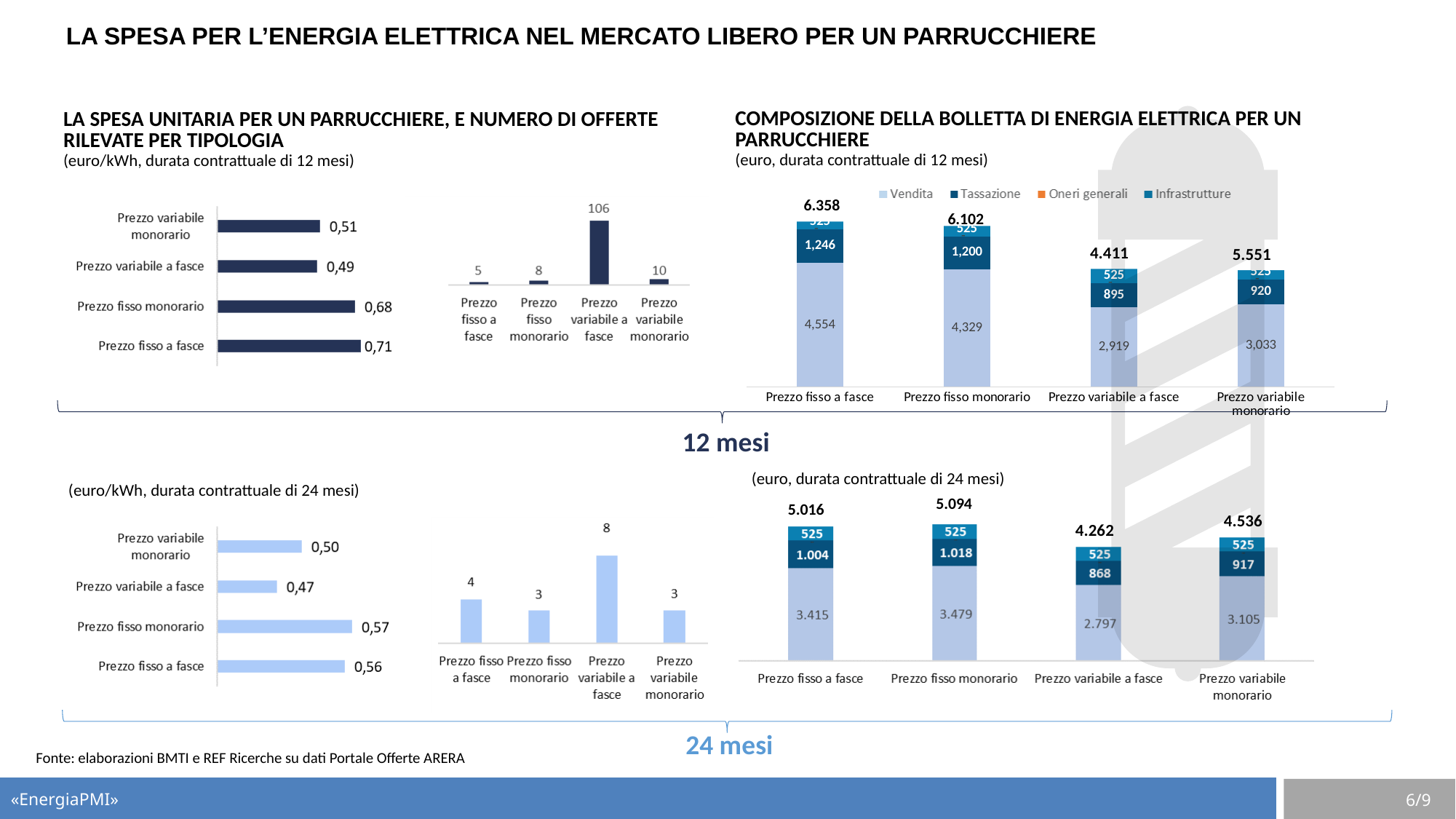
In the bottom-right stacked bar chart (euro, 24 mesi), what is the Tassazione value for Prezzo variabile monorario? 917 In the top-middle bar chart showing the number of offers for 12 mesi, what is the difference between Prezzo variabile monorario and Prezzo fisso a fasce? 5 In the bottom-left horizontal bar chart (euro/kWh, 24 mesi), what is the value for Prezzo fisso monorario? 0,57 In the bottom-middle bar chart showing the number of offers for 24 mesi, which category has the highest value? Prezzo variabile a fasce In the top-right stacked bar chart (euro, 12 mesi), what is the total for Prezzo fisso a fasce? 6.358 How many series does the legend of the top-right stacked bar chart list? 4 What kind of chart is the top-right chart titled 'Composizione della bolletta di energia elettrica per un parrucchiere'? Stacked bar chart In the bottom-left horizontal bar chart (euro/kWh, 24 mesi), which is larger: Prezzo fisso a fasce or Prezzo variabile monorario? Prezzo fisso a fasce In the top-middle bar chart showing the number of offers for 12 mesi, what is the value for Prezzo variabile a fasce? 106 In the top-left horizontal bar chart (euro/kWh, 12 mesi), what is the value for Prezzo fisso a fasce? 0,71 In the top-left horizontal bar chart (euro/kWh, 12 mesi), which category has the lowest value? Prezzo variabile a fasce In the top-right stacked bar chart (euro, 12 mesi), what is the Vendita value for Prezzo variabile a fasce? 2,919